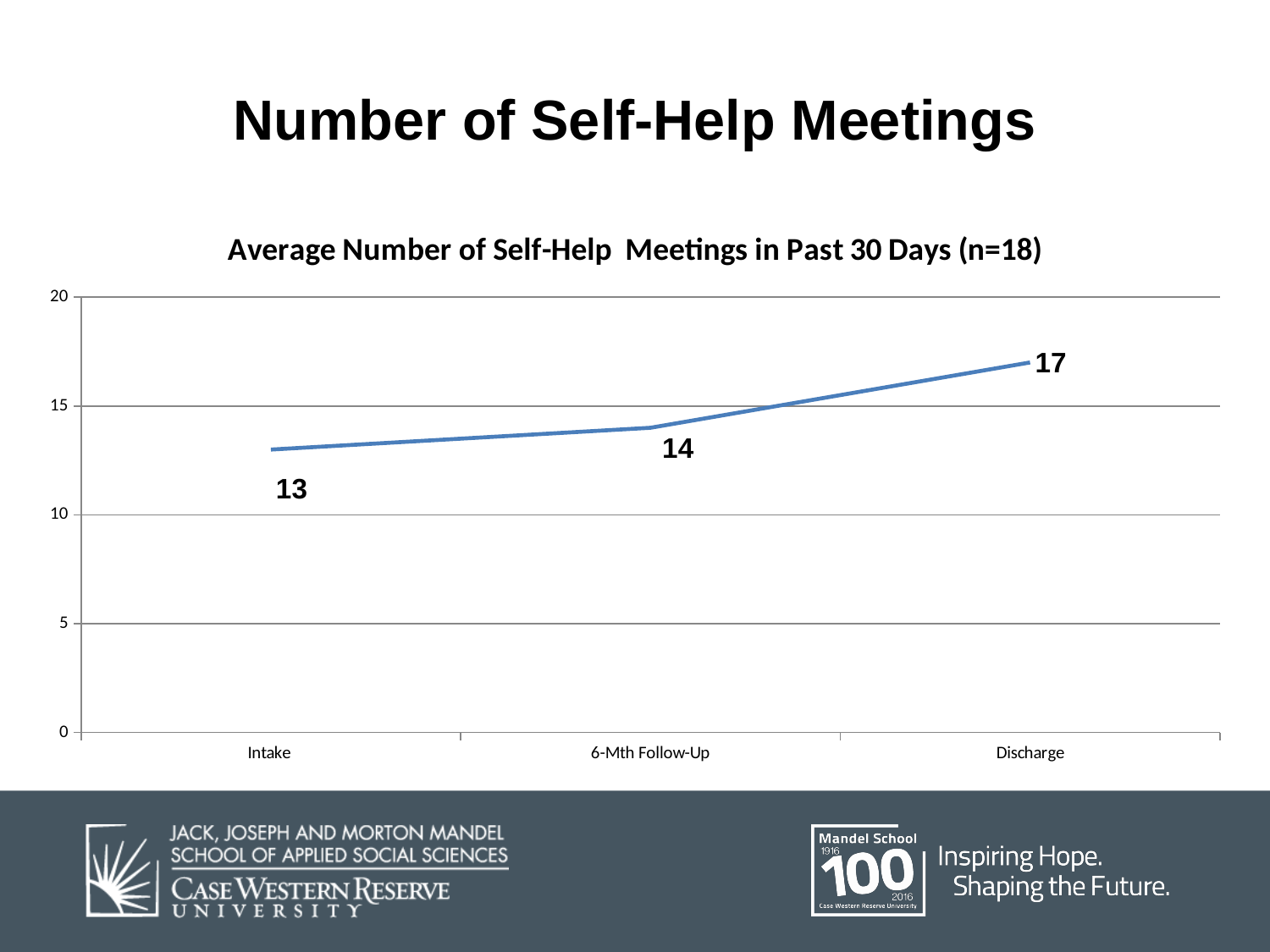
What is the difference between the value at Discharge and the value at Intake? 4 What is the average number of self-help meetings at Discharge? 17 At which time point is the average number of self-help meetings highest? Discharge How many time points are plotted on the chart? 3 Which is larger, the value at Discharge or the value at 6-Mth Follow-Up? Discharge Do the values rise or fall from Intake to Discharge? rise What kind of chart is shown on the slide? line chart At which time point is the average number of self-help meetings lowest? Intake Is the value at Discharge greater or less than 15? greater What is the average number of self-help meetings at Intake? 13 What is the difference between the value at 6-Mth Follow-Up and the value at Intake? 1 What is the average number of self-help meetings at 6-Mth Follow-Up? 14